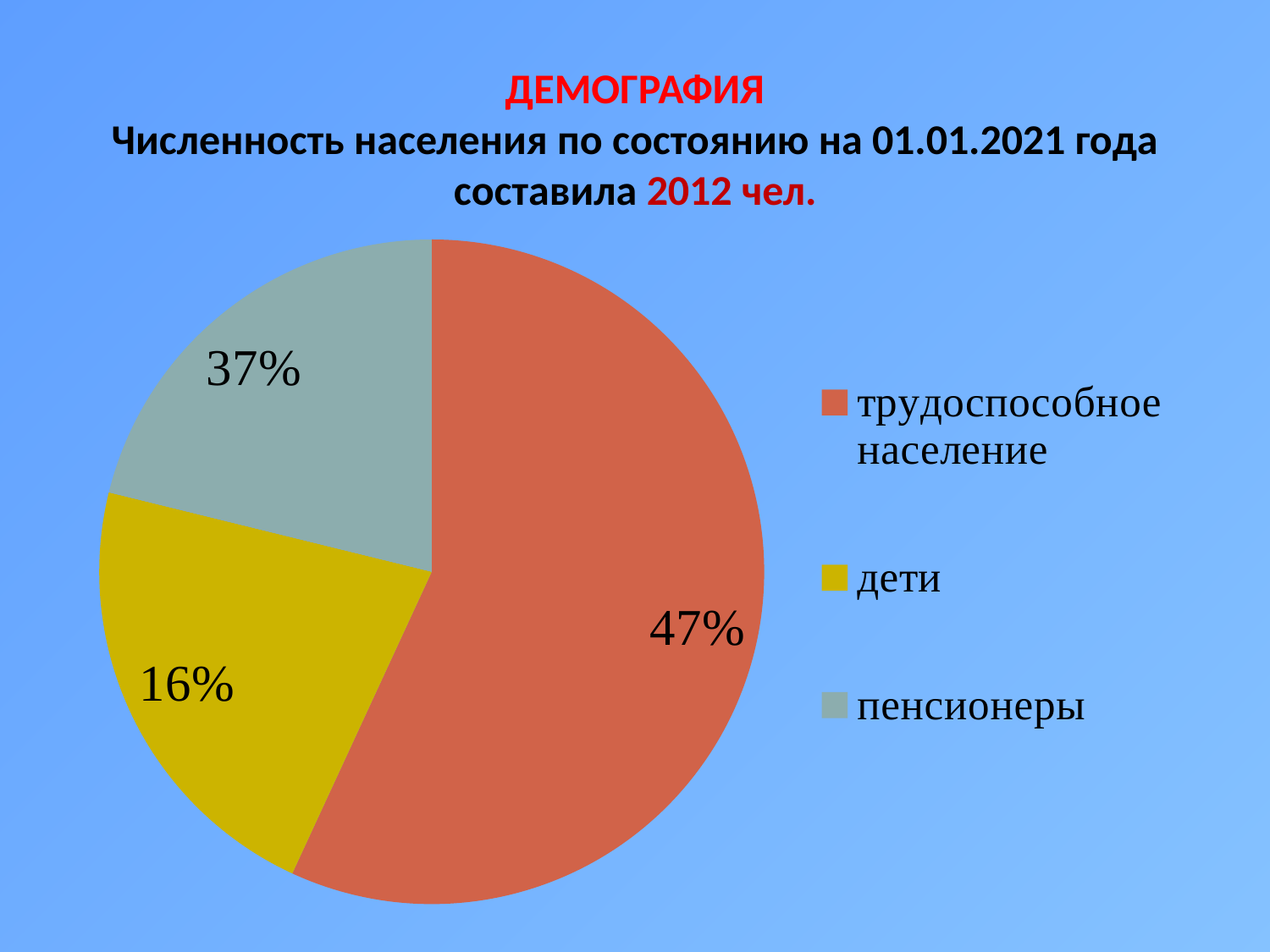
Which category has the largest slice of the pie? трудоспособное население Which is larger, the share for пенсионеры or the share for дети? пенсионеры What share of the pie does пенсионеры have? 37% What is the difference in percentage points between трудоспособное население and пенсионеры? 10 What colour is the slice for дети? yellow How many entries does the legend list? 3 What share of the pie does дети have? 16% What is the difference in percentage points between пенсионеры and дети? 21 How many slices does the pie chart have? 3 Which category has the smallest slice of the pie? дети What kind of chart is shown on the slide? pie chart What share of the pie does трудоспособное население have? 47%